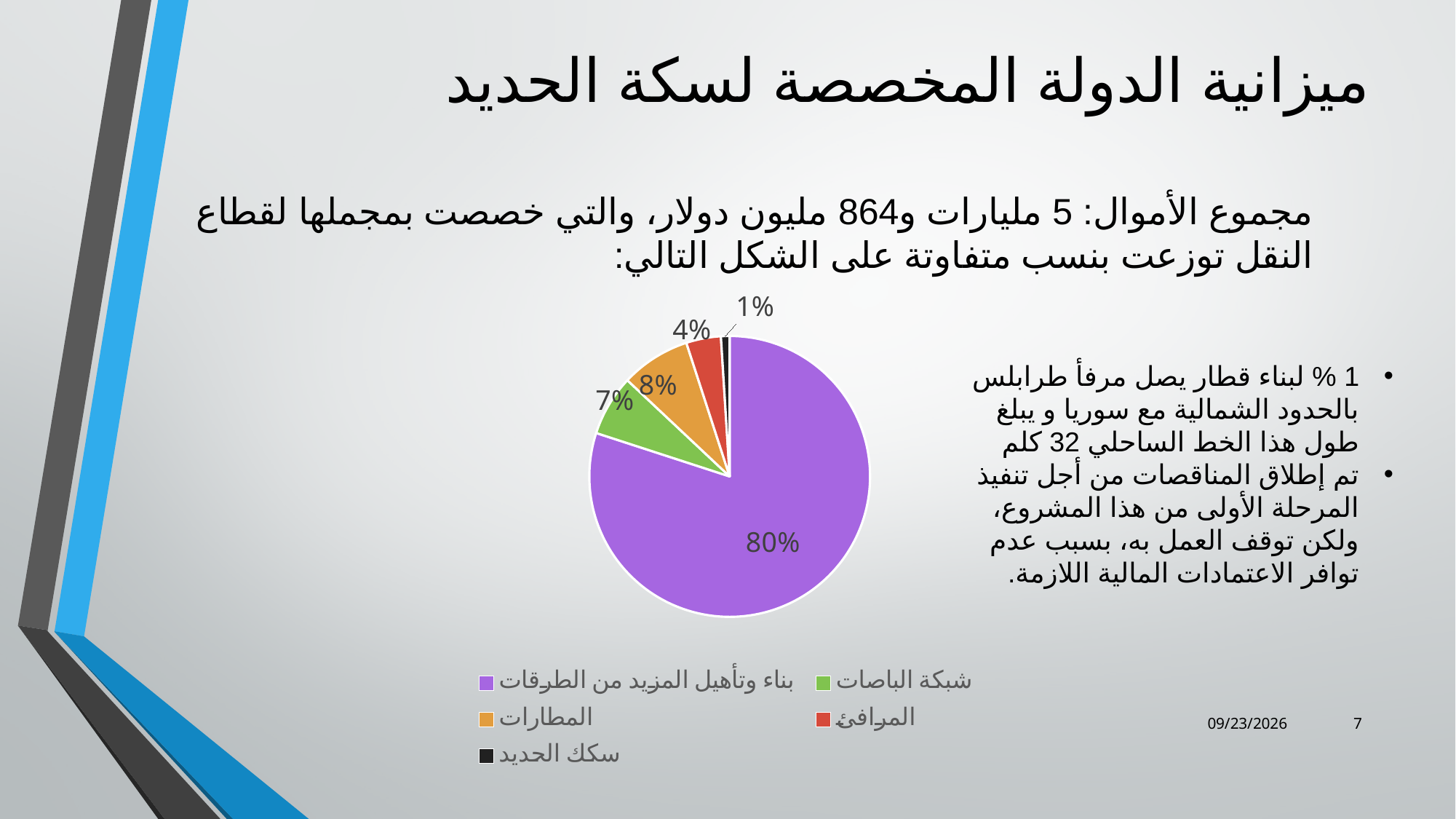
What colour is the slice for سكك الحديد? black What share of the pie does بناء وتأهيل المزيد من الطرقات take? 80% What type of chart is shown on the slide? pie chart Which is larger, the slice for المطارات or the slice for شبكة الباصات? المطارات How many slices does the pie chart have? 5 What percentage is shown for شبكة الباصات? 7% Which category has the largest slice of the pie? بناء وتأهيل المزيد من الطرقات What percentage is shown for المطارات? 8% What percentage is shown for سكك الحديد? 1% What is the difference in percentage points between المطارات and المرافئ? 4 Which category has the smallest slice of the pie? سكك الحديد What percentage is shown for المرافئ? 4%